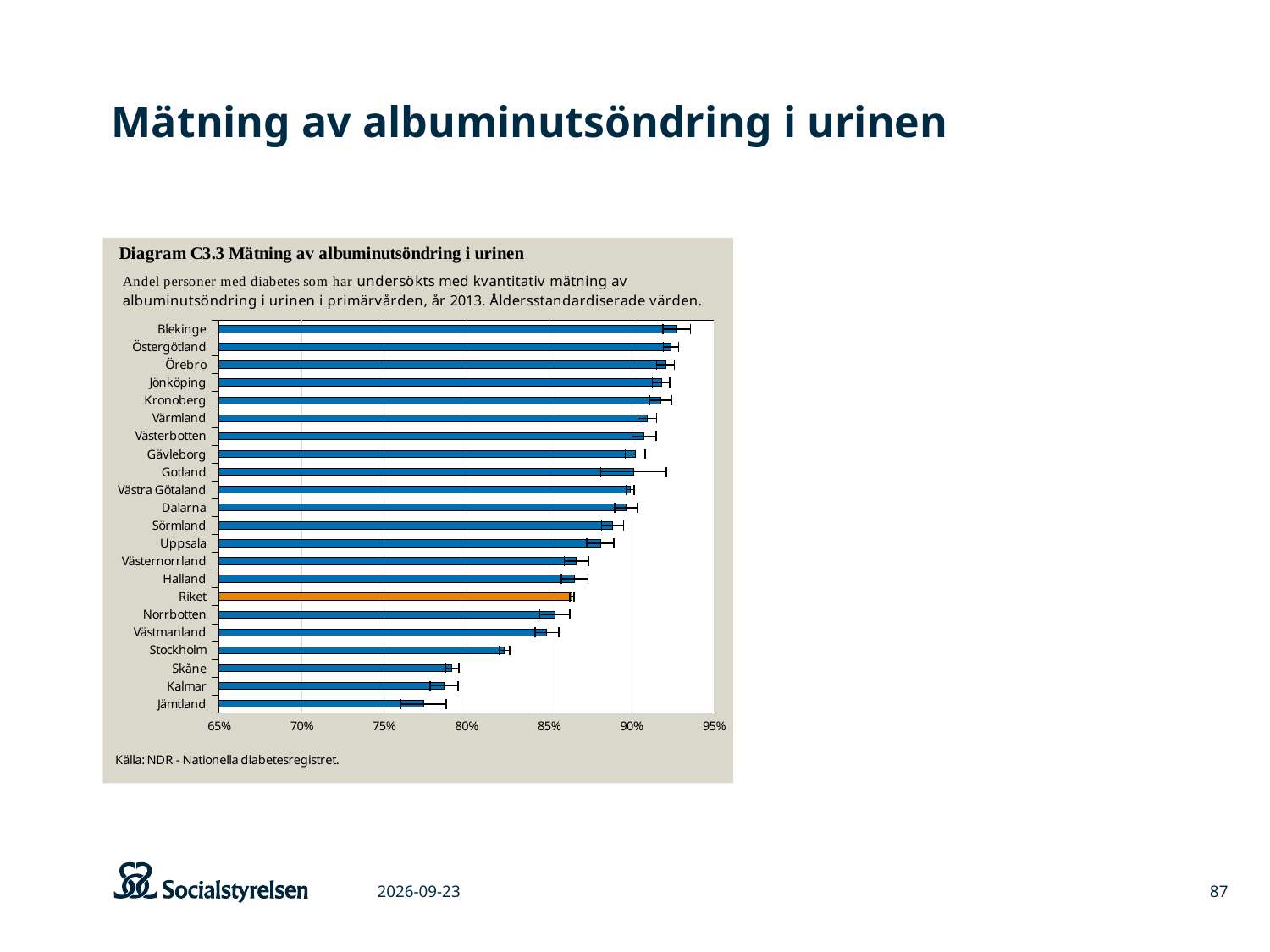
Is the value for Blekinge greater or less than 90%? greater What kind of chart is shown on the slide? bar chart Is the value for Uppsala greater or less than 85%? greater Which has a higher value, Stockholm or Skåne? Stockholm How many categories (bars) are shown in the chart? 22 Which bar is shown in a different colour (orange) from the others? Riket What is the source cited below the chart? NDR - Nationella diabetesregistret Which category has the lowest value in the chart? Jämtland Is the value for Jämtland greater or less than 80%? less Which category has the highest value in the chart? Blekinge